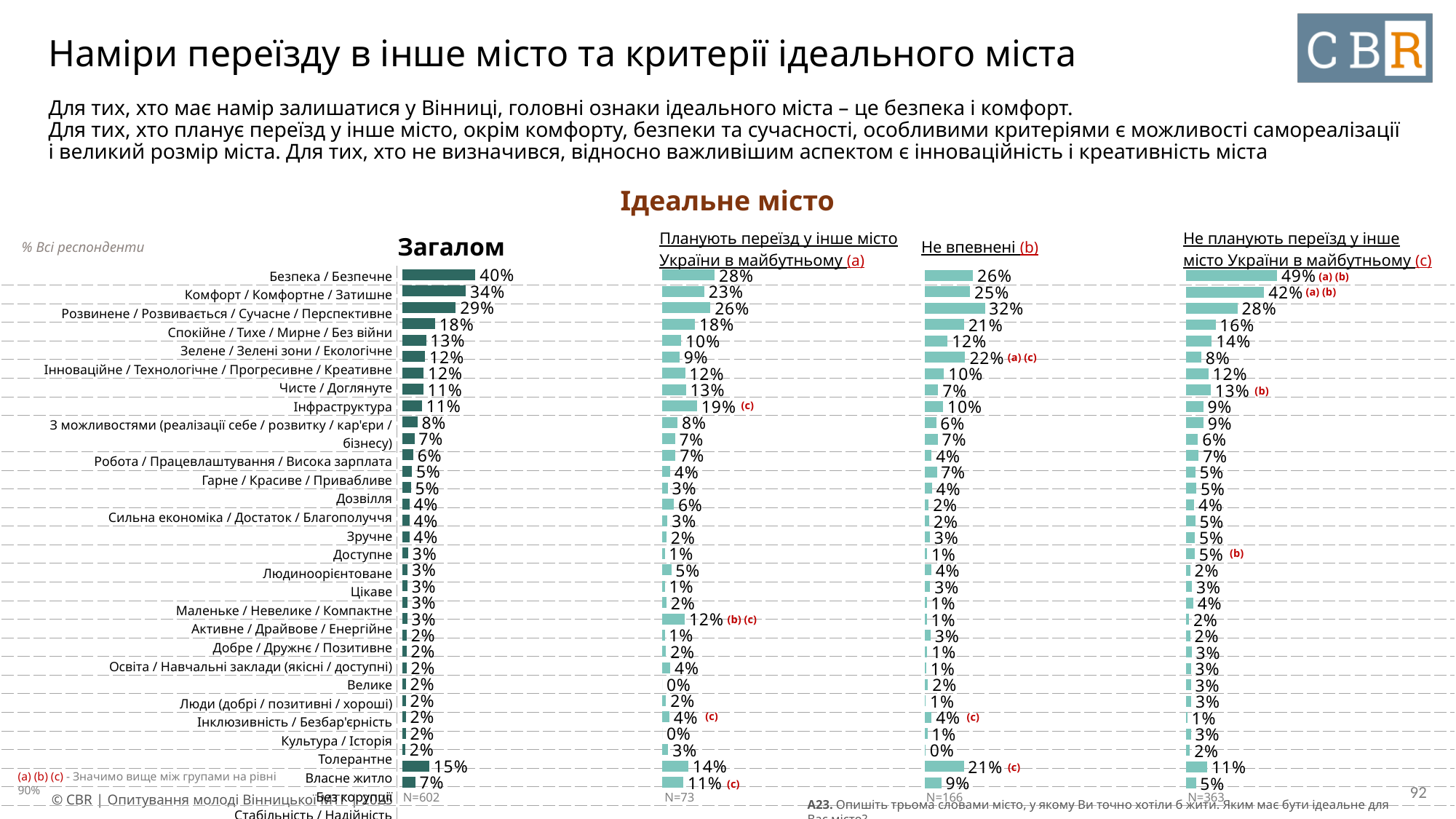
In the 'Не впевнені (b)' chart, what is the value for 'Розвинене / Розвивається / Сучасне / Перспективне'? 32% In the 'Не планують переїзд у інше місто України в майбутньому (c)' chart, what is the value for 'Безпека / Безпечне'? 49% In the 'Загалом' chart, which category has the highest value? Безпека / Безпечне What is the sample size (N) shown under the 'Планують переїзд у інше місто України в майбутньому (a)' chart? N=73 In the 'Не впевнені (b)' chart, which category has the highest value? Розвинене / Розвивається / Сучасне / Перспективне In the 'Загалом' chart, what is the difference between 'Безпека / Безпечне' and 'Комфорт / Комфортне / Затишне'? 6 percentage points In the 'Загалом' chart, what is the value for 'Безпека / Безпечне'? 40% What is the difference in the 'Безпека / Безпечне' value between the 'Не планують переїзд (c)' chart and the 'Планують переїзд (a)' chart? 21 percentage points What kind of chart is used for the 'Загалом' data? Bar chart In the 'Загалом' chart, which is larger: 'Комфорт / Комфортне / Затишне' or 'Розвинене / Розвивається / Сучасне / Перспективне'? Комфорт / Комфортне / Затишне